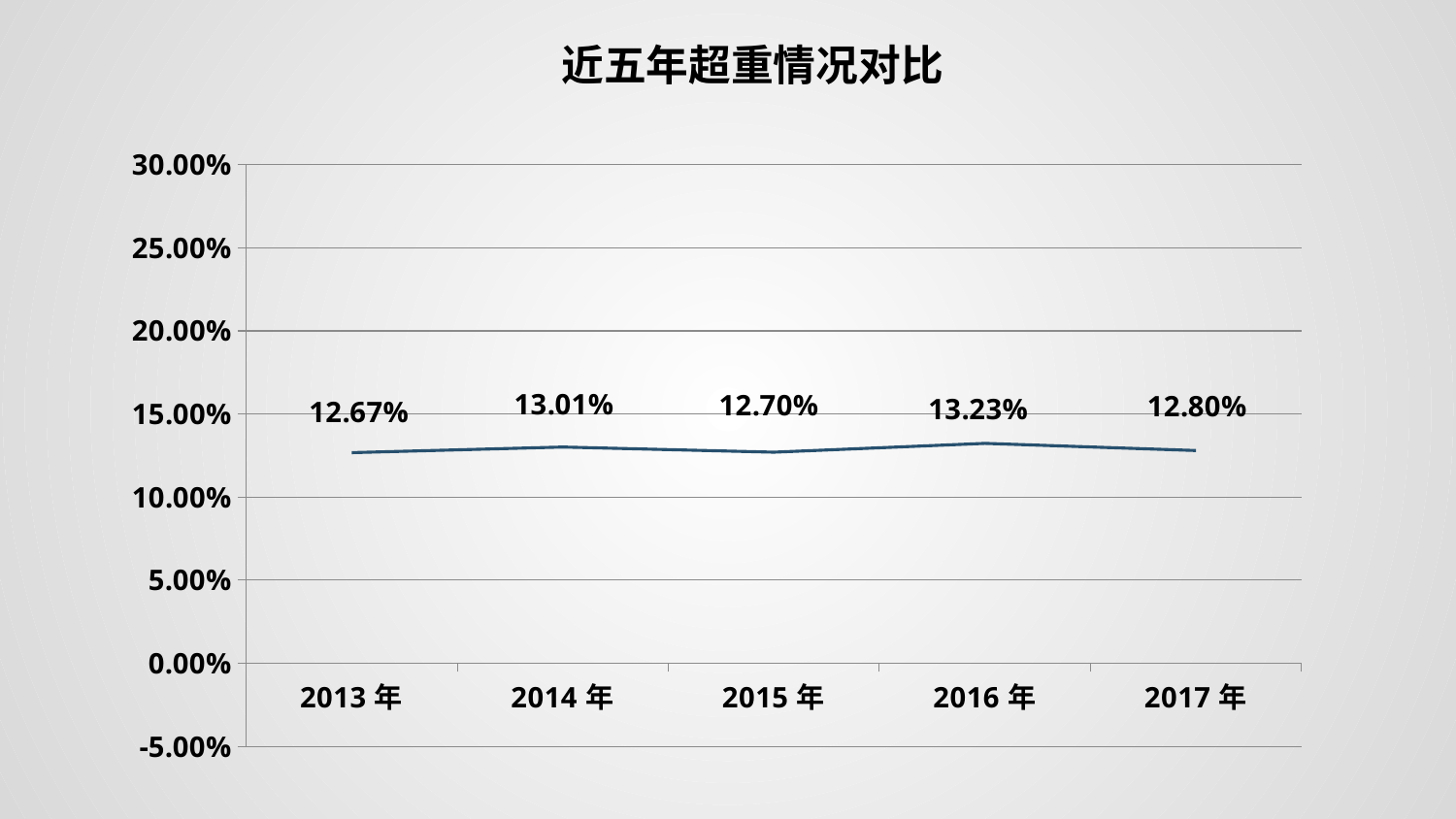
How many years are plotted on the chart? 5 Which year has the lowest value? 2013 年 What kind of chart is shown on the slide? line chart What is the value for 2017 年? 12.80% Which is larger, the value for 2014 年 or the value for 2017 年? 2014 年 What is the value for 2014 年? 13.01% What is the title of the chart? 近五年超重情况对比 What is the value for 2015 年? 12.70% Which year has the highest value? 2016 年 What is the value for 2013 年? 12.67% What is the value for 2016 年? 13.23% What is the difference between the values for 2016 年 and 2013 年? 0.56%